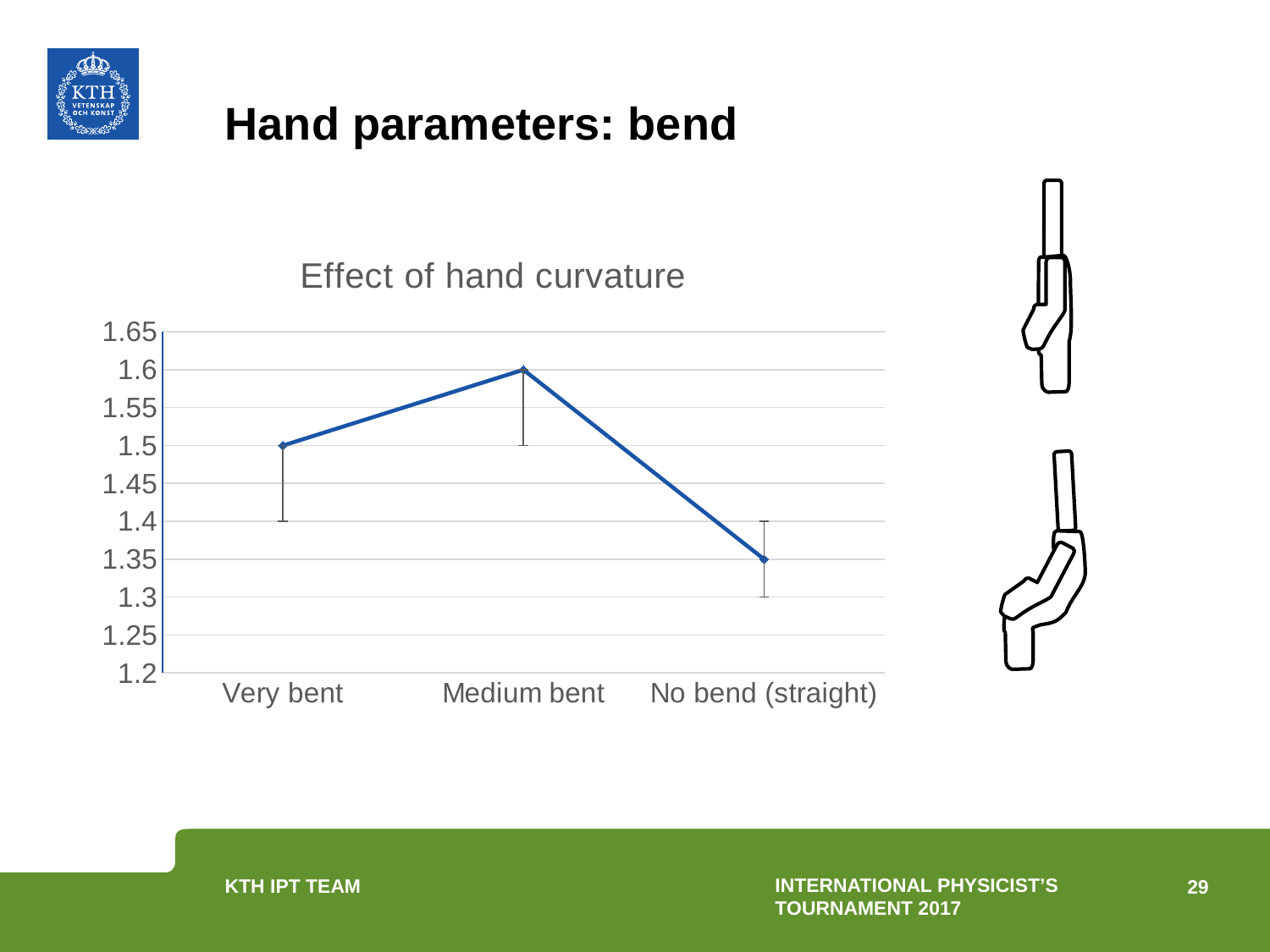
Is the value for No bend (straight) greater or less than 1.4? less What type of chart is shown on the slide? line chart What is the title of the chart? Effect of hand curvature Which category has the highest value? Medium bent What is the value for Medium bent? 1.6 Which is larger, the value for Very bent or the value for No bend (straight)? Very bent What is the value for Very bent? 1.5 Which category has the lowest value? No bend (straight) What is the difference between the values for Medium bent and Very bent? 0.1 What is the difference between the values for Medium bent and No bend (straight)? 0.25 How many categories are plotted on the x axis? 3 What is the value for No bend (straight)? 1.35